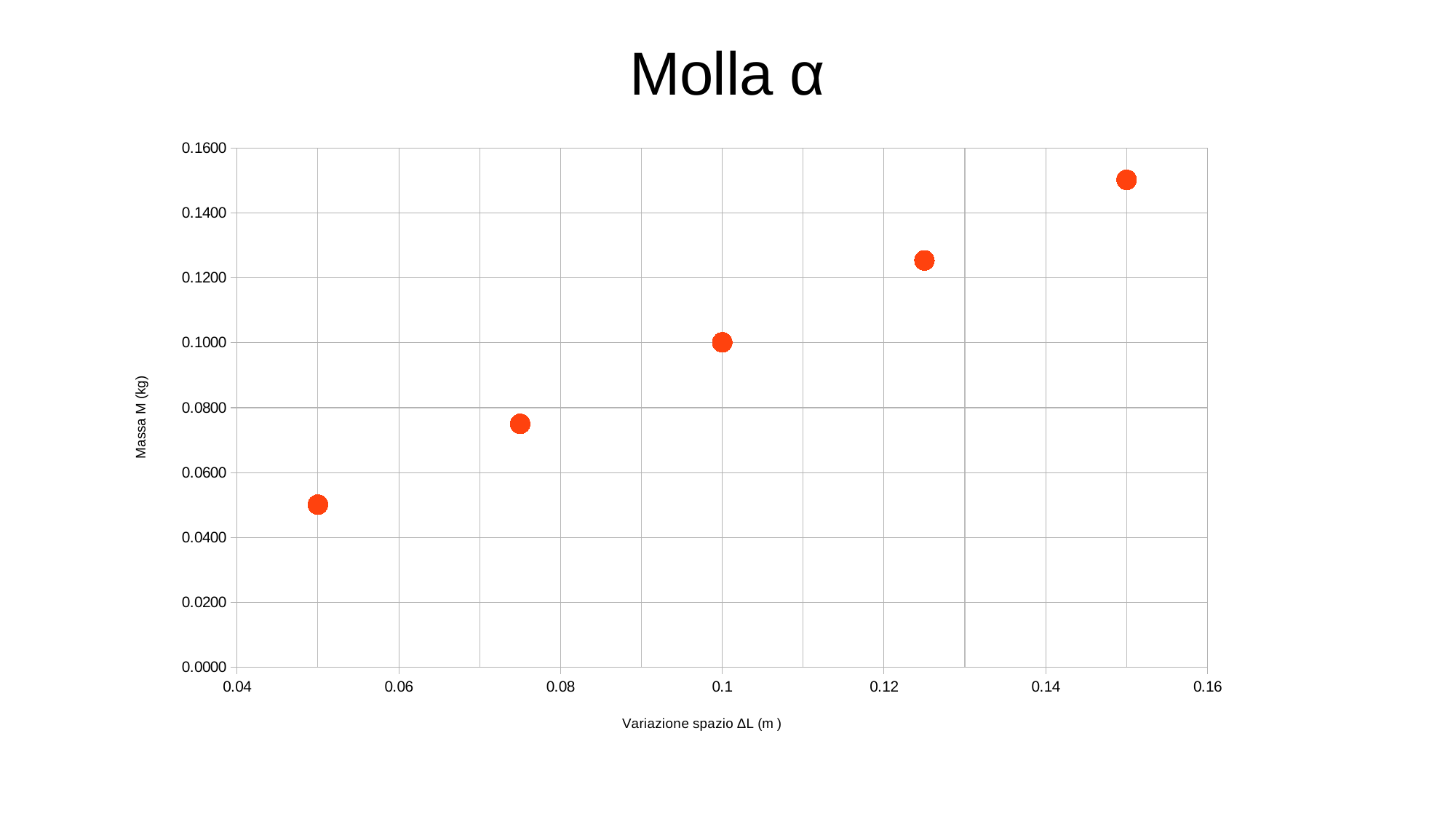
Which point has the highest Massa M value, the leftmost or the rightmost? The rightmost What kind of chart is shown on the slide? Scatter chart What is the title of the chart? Molla α Which point has the lowest Massa M value, the leftmost or the rightmost? The leftmost Do the values of Massa M rise or fall as Variazione spazio ΔL increases? Rise How many data points are plotted on the chart? 5 What is the Massa M value of the point at Variazione spazio ΔL = 0.1? 0.1000 Is the Massa M value of the second point from the right greater or less than 0.1200? greater Is the Massa M value of the rightmost point greater or less than 0.1400? greater Which has the larger Massa M value, the second point from the left or the point at ΔL = 0.1? The point at ΔL = 0.1 Is the Massa M value of the leftmost point greater or less than 0.0600? less What is the label of the y axis? Massa M (kg)